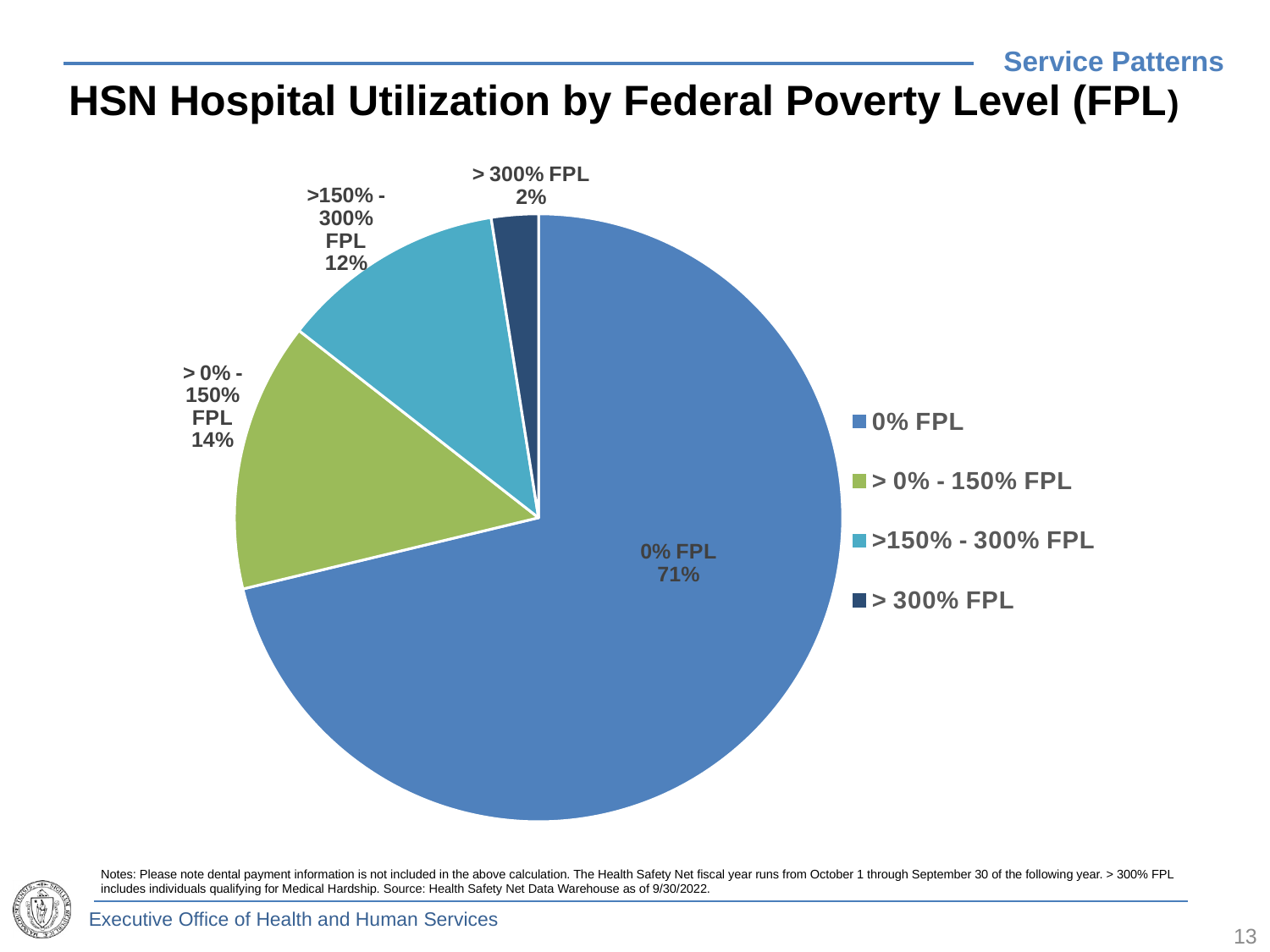
What is the title of the chart? HSN Hospital Utilization by Federal Poverty Level (FPL) What is the difference in percentage points between the 0% FPL slice and the > 0% - 150% FPL slice? 57 What percentage is shown for the > 300% FPL slice? 2% What percentage of the pie is the > 0% - 150% FPL slice? 14% What percentage is shown for the >150% - 300% FPL slice? 12% How many slices does the pie chart have? 4 Which FPL group has the smallest share of HSN hospital utilization? > 300% FPL What kind of chart is shown on the slide? Pie chart What share of HSN hospital utilization is attributed to the 0% FPL group? 71% Which slice is larger: > 0% - 150% FPL or >150% - 300% FPL? > 0% - 150% FPL What colour is the 0% FPL slice in the pie chart? Blue Which FPL group has the largest share of HSN hospital utilization? 0% FPL